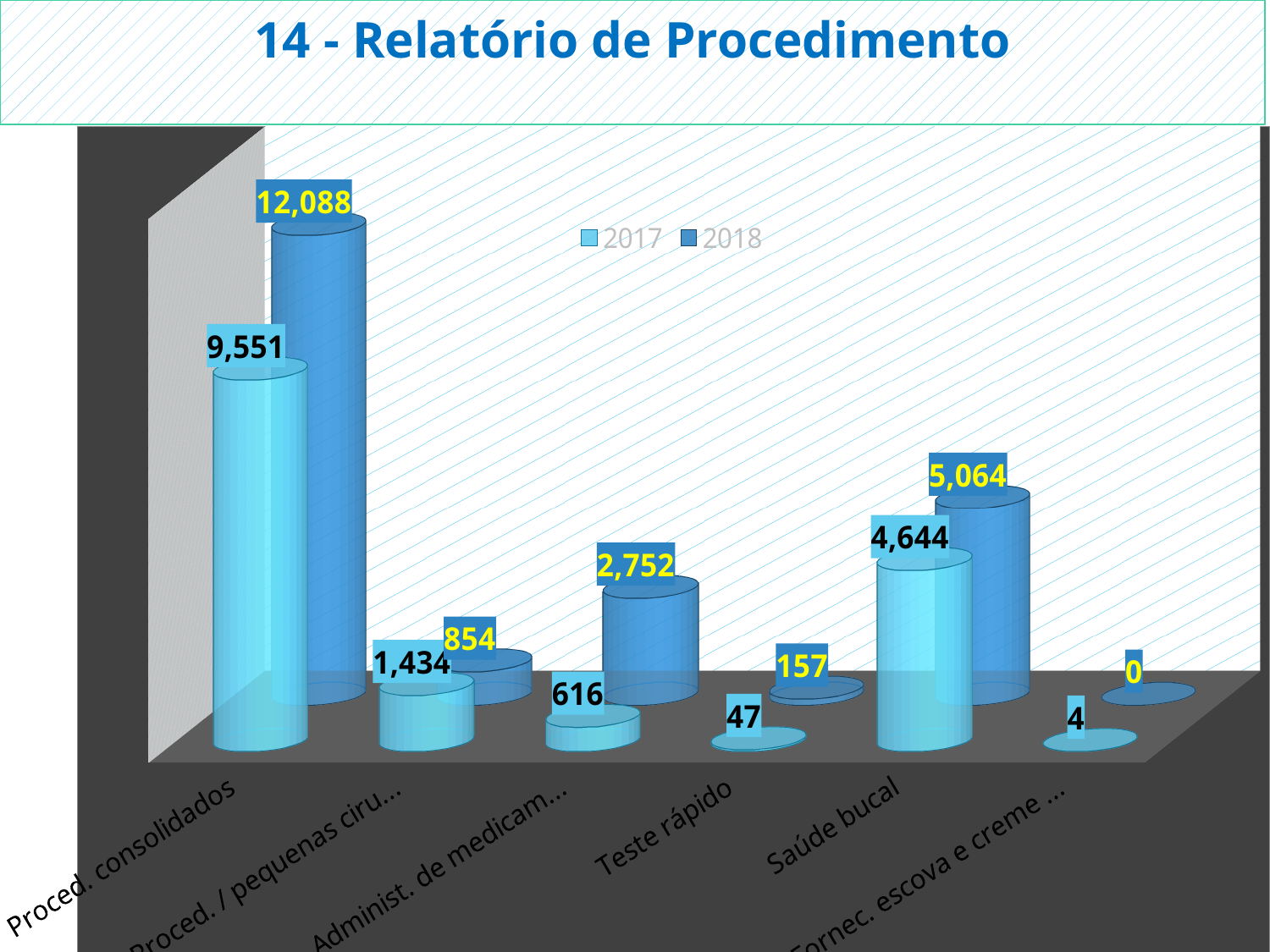
What kind of chart is shown on the slide? Bar chart Which category has the lowest 2017 value? Fornec. escova e creme ... What is the difference between the 2018 and 2017 values for Proced. consolidados? 2,537 How many series does the legend list? 2 What is the 2017 value for Saúde bucal? 4,644 What is the 2017 value for Administ. de medicam...? 616 How many categories are shown on the x axis? 6 What is the 2018 value for Teste rápido? 157 Which category has the highest 2018 value? Proced. consolidados For Proced. / pequenas ciru..., which year has the larger value, 2017 or 2018? 2017 What is the 2018 value for Proced. consolidados? 12,088 What is the difference between the 2018 and 2017 values for Administ. de medicam...? 2,136